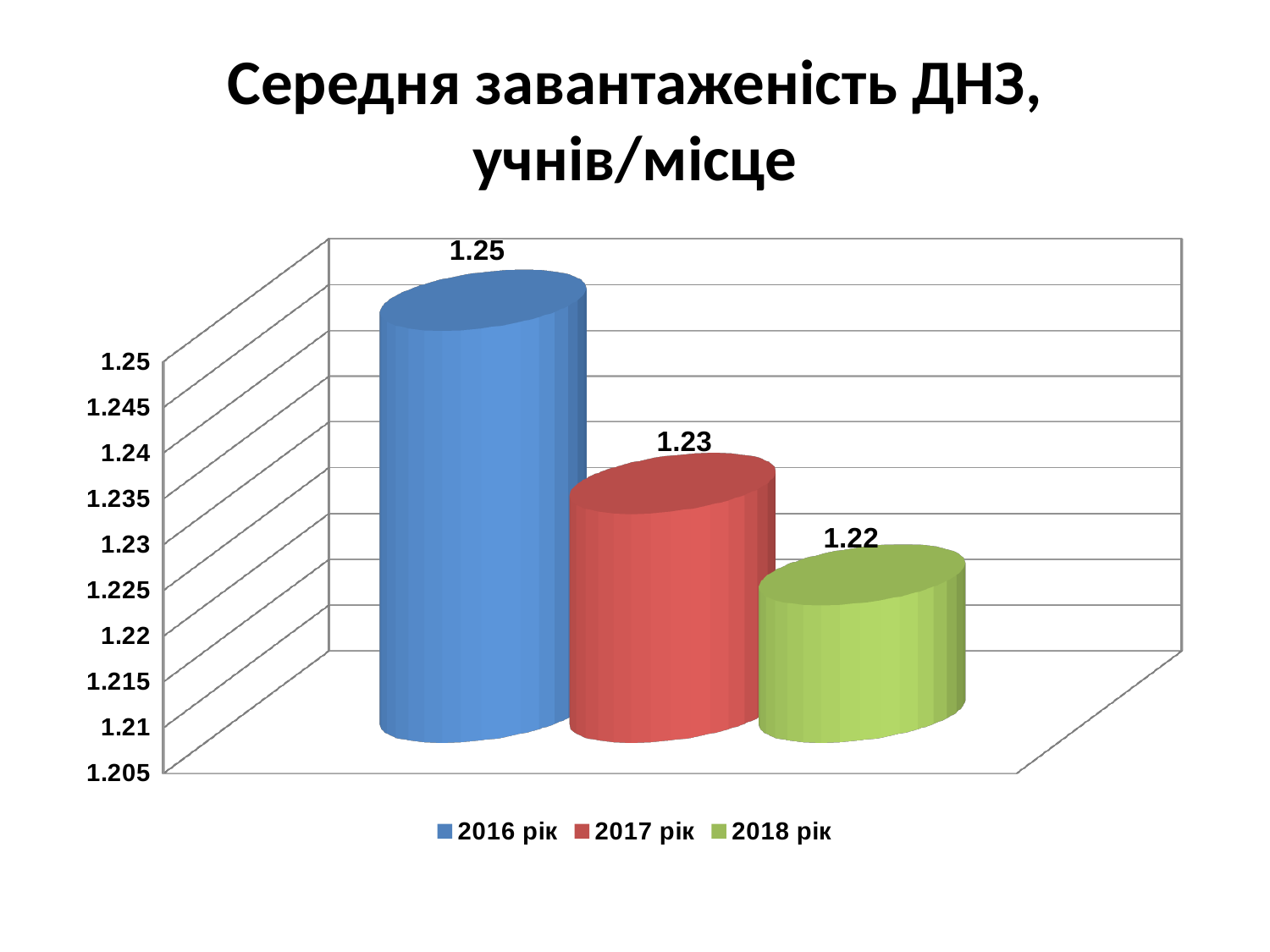
How many series does the legend list? 3 What is the difference between the values for 2017 рік and 2018 рік? 0.01 Which is larger, the value for 2016 рік or 2017 рік? 2016 рік What is the difference between the values for 2016 рік and 2018 рік? 0.03 What is the value for 2018 рік? 1.22 Which year has the highest value? 2016 рік What is the value for 2016 рік? 1.25 What kind of chart is shown? bar chart What is the value for 2017 рік? 1.23 What is the title of the chart? Середня завантаженість ДНЗ, учнів/місце Which year has the lowest value? 2018 рік Do the values rise or fall from 2016 рік to 2018 рік? fall